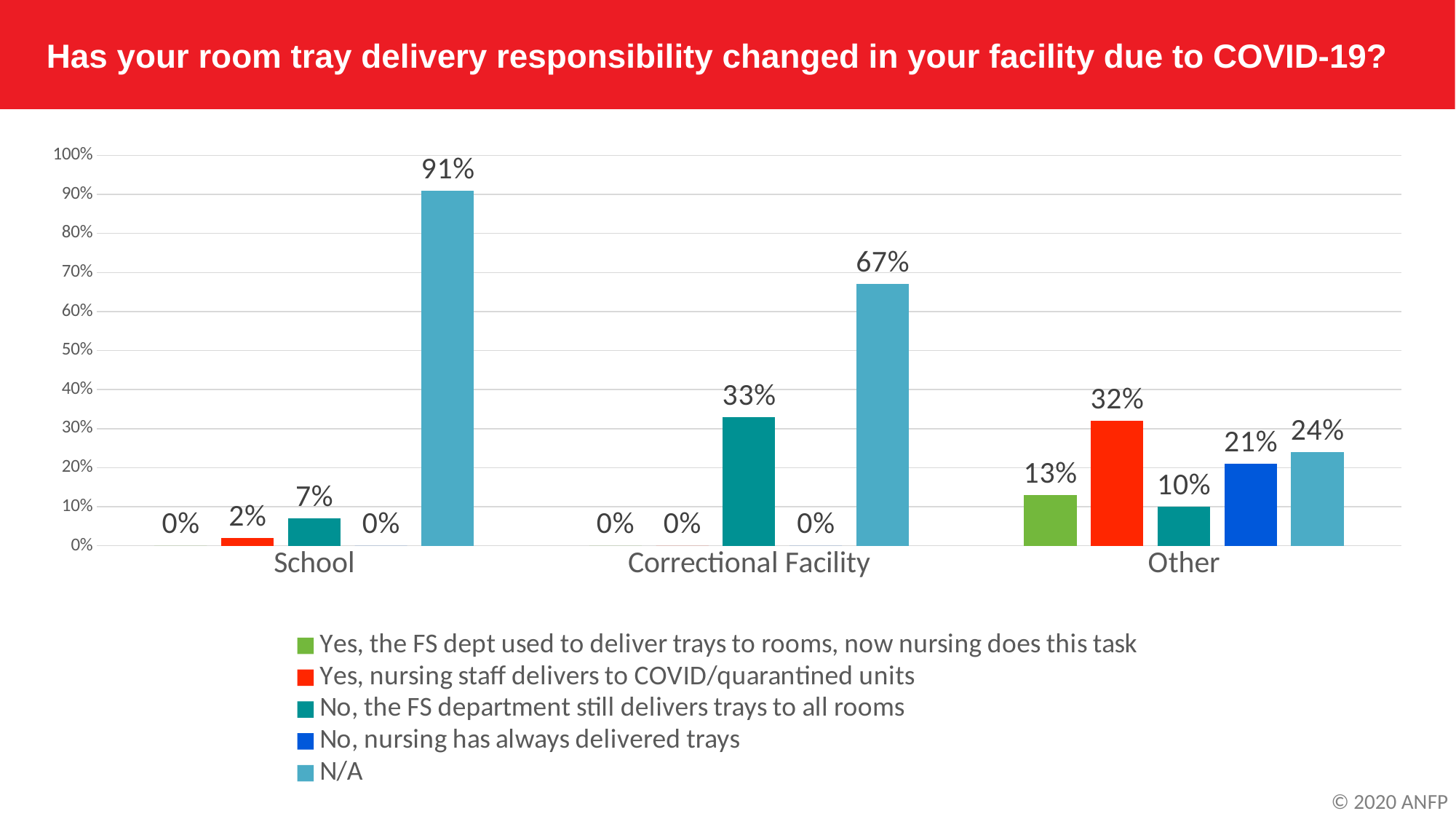
Which facility type has the lowest N/A value? Other How many series does the legend list? 5 Which is larger for Other: 'Yes, the FS dept used to deliver trays to rooms, now nursing does this task' or 'No, nursing has always delivered trays'? No, nursing has always delivered trays What kind of chart is shown on the slide? Bar chart What is the difference between the N/A values for School and Correctional Facility? 24% Which facility type has the highest N/A value? School What is the value for 'Yes, nursing staff delivers to COVID/quarantined units' for Other? 32% What is the value for 'No, the FS department still delivers trays to all rooms' for Correctional Facility? 33% What is the N/A value for School? 91% What is the value for 'No, nursing has always delivered trays' for Other? 21% What is the total of the five values for Other? 100% How many facility types are shown on the x axis? 3